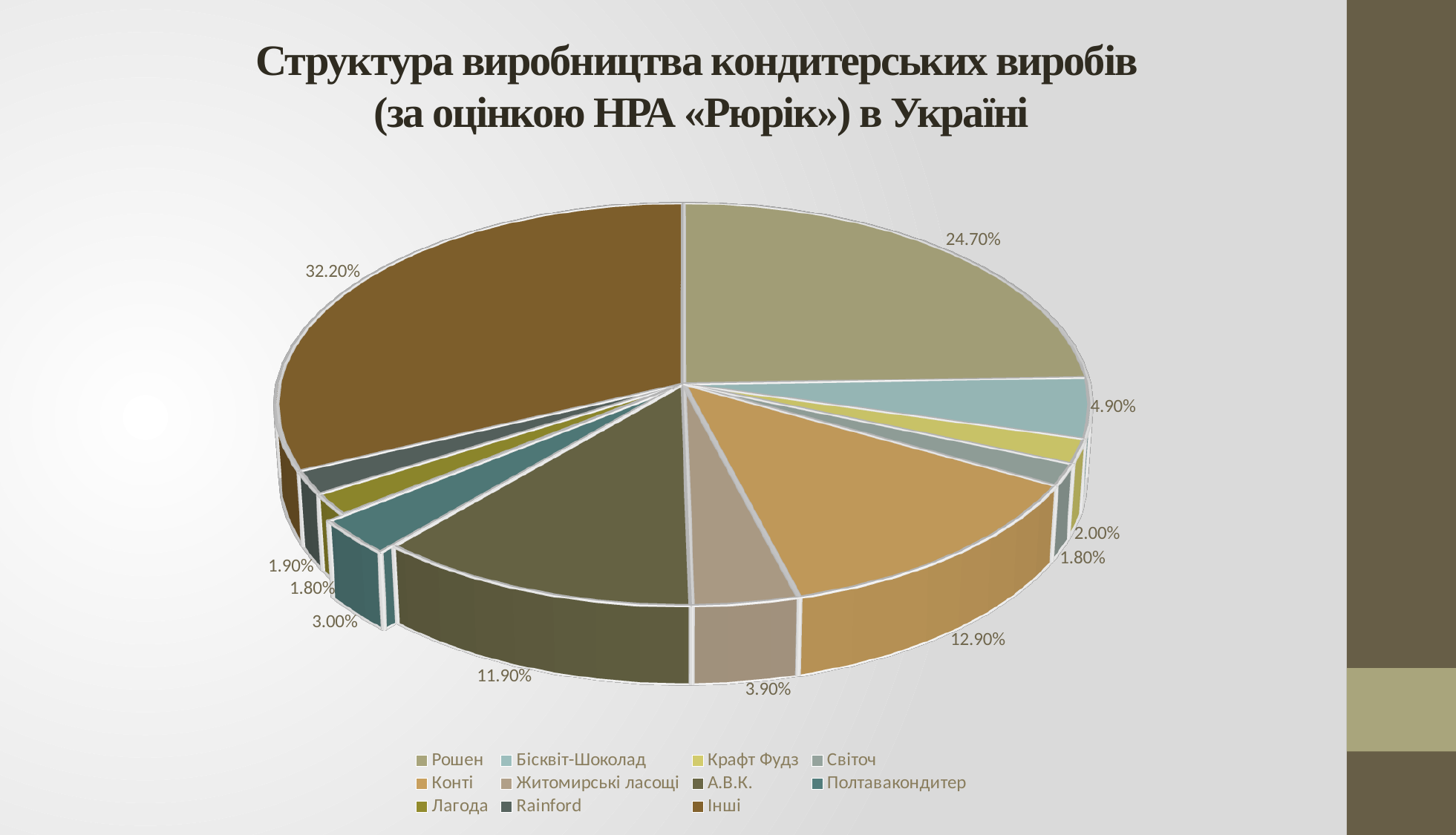
What is the difference between the shares of Житомирські ласощі and Крафт Фудз? 1.90% What is the difference between the shares of Інші and Рошен? 7.50% How many slices does the pie chart have? 11 What is the value shown for Бісквіт-Шоколад? 4.90% Which category has the largest slice of the pie? Інші Which is larger, the share of Конті or the share of А.В.К.? Конті What kind of chart is shown on the slide? pie chart What share of confectionery production does Рошен hold? 24.70% How many entries does the legend list? 11 What is the value shown for Конті? 12.90% What is the value shown for Полтавакондитер? 3.00% What is the value shown for А.В.К.? 11.90%